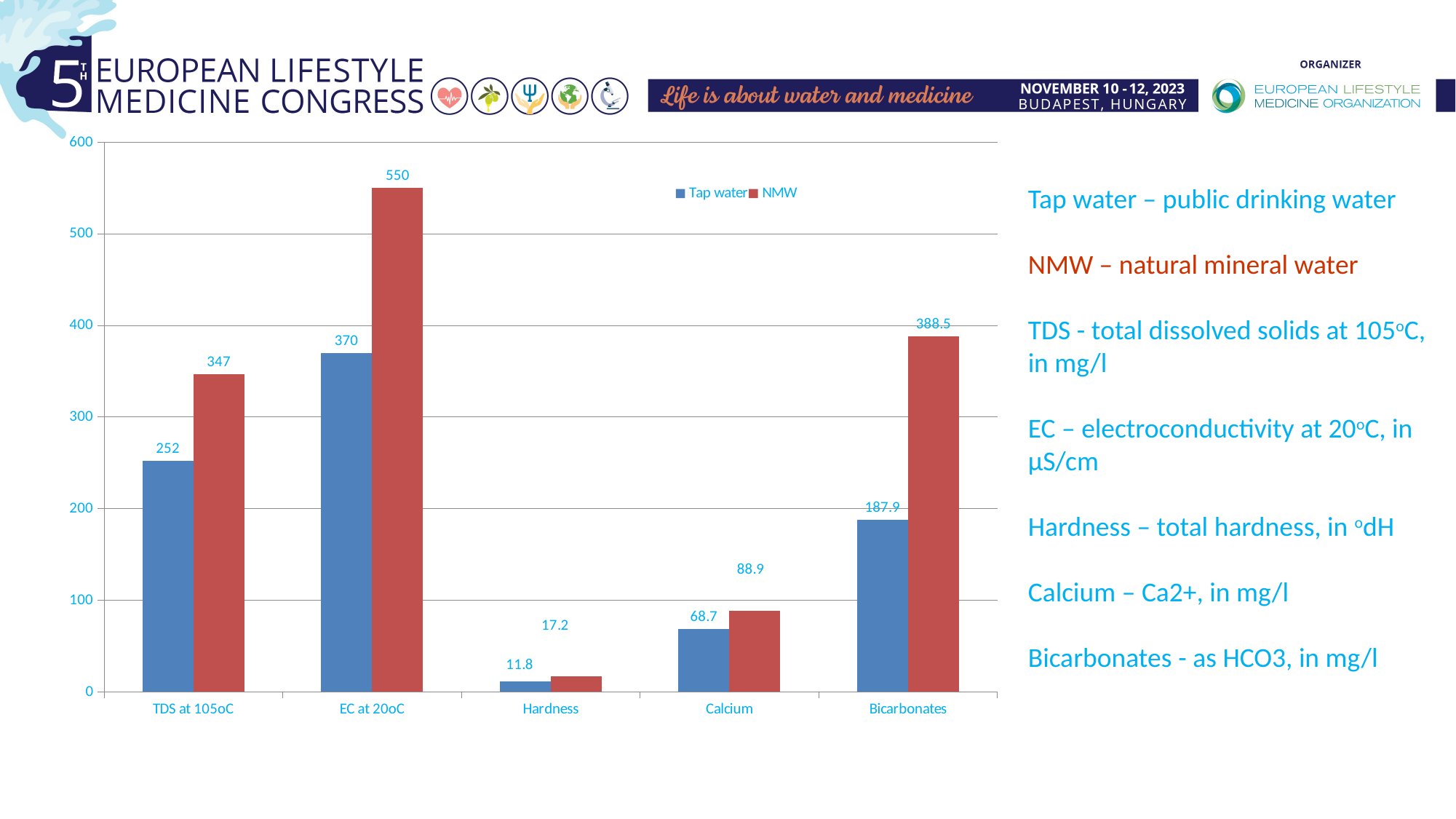
What is the Tap water value for Calcium? 68.7 Which is larger for Hardness, the Tap water value or the NMW value? NMW Which category has the lowest Tap water value? Hardness What kind of chart is shown on the slide? Bar chart Which category has the highest NMW value? EC at 20oC What is the NMW value for EC at 20oC? 550 What is the difference between the NMW and Tap water values for Bicarbonates? 200.6 What is the NMW value for Bicarbonates? 388.5 What is the difference between the NMW and Tap water values for TDS at 105oC? 95 How many series does the legend list? 2 How many categories are shown on the x axis? 5 What is the Tap water value for TDS at 105oC? 252